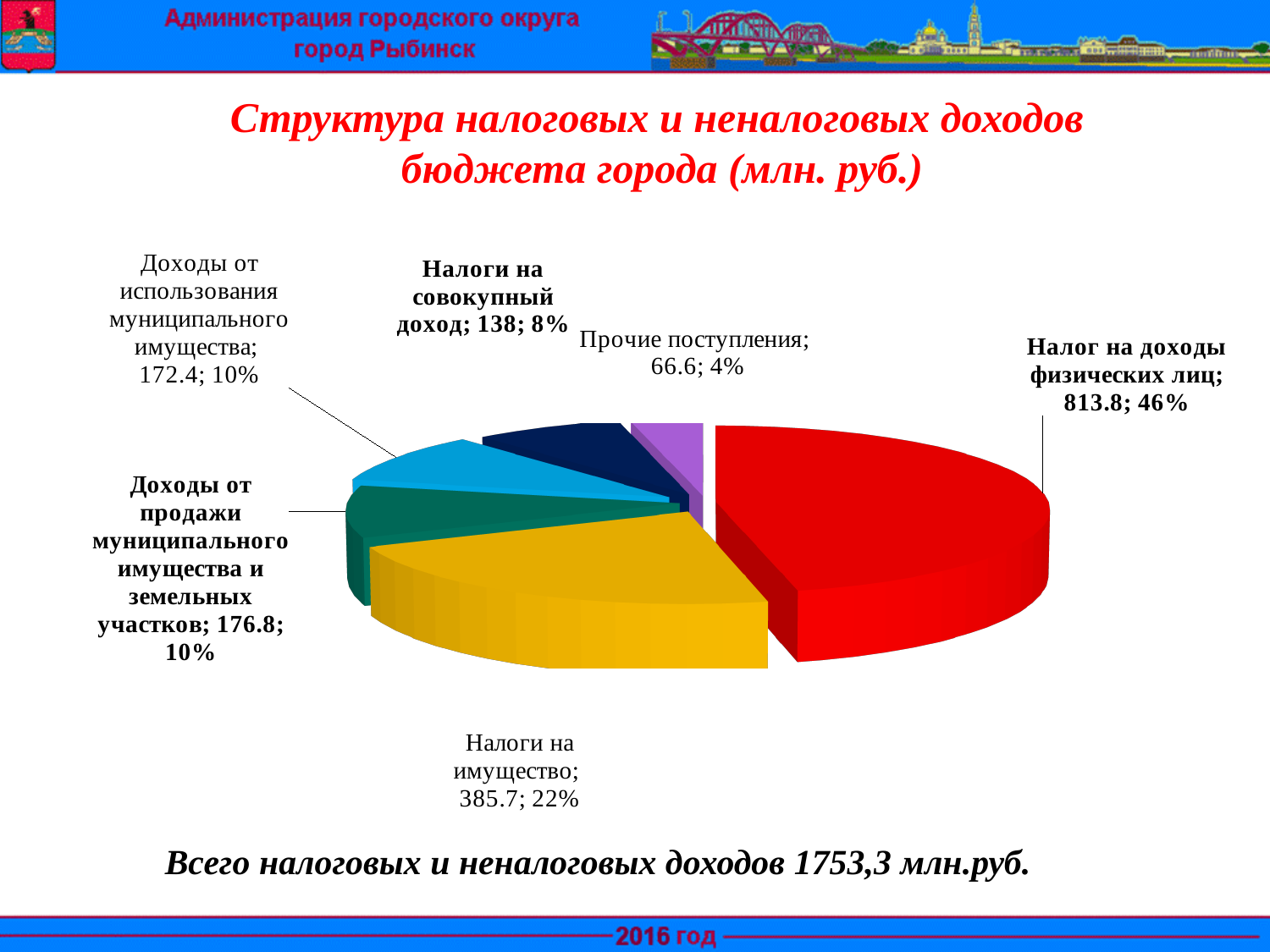
What total of tax and non-tax revenues is stated below the chart? 1753,3 млн.руб. What is the value for Налоги на совокупный доход? 138 Which category has the smallest slice of the pie? Прочие поступления What share of the pie does Налоги на имущество represent? 22% Which is larger: the value for Доходы от продажи муниципального имущества и земельных участков or the value for Доходы от использования муниципального имущества? Доходы от продажи муниципального имущества и земельных участков What is the difference between the values for Налог на доходы физических лиц and Налоги на имущество? 428.1 What is the value for Доходы от использования муниципального имущества? 172.4 What share of the pie does Прочие поступления represent? 4% How many slices does the pie chart have? 6 What kind of chart is shown on the slide? pie chart Which category has the largest slice of the pie? Налог на доходы физических лиц What is the value for Налог на доходы физических лиц? 813.8